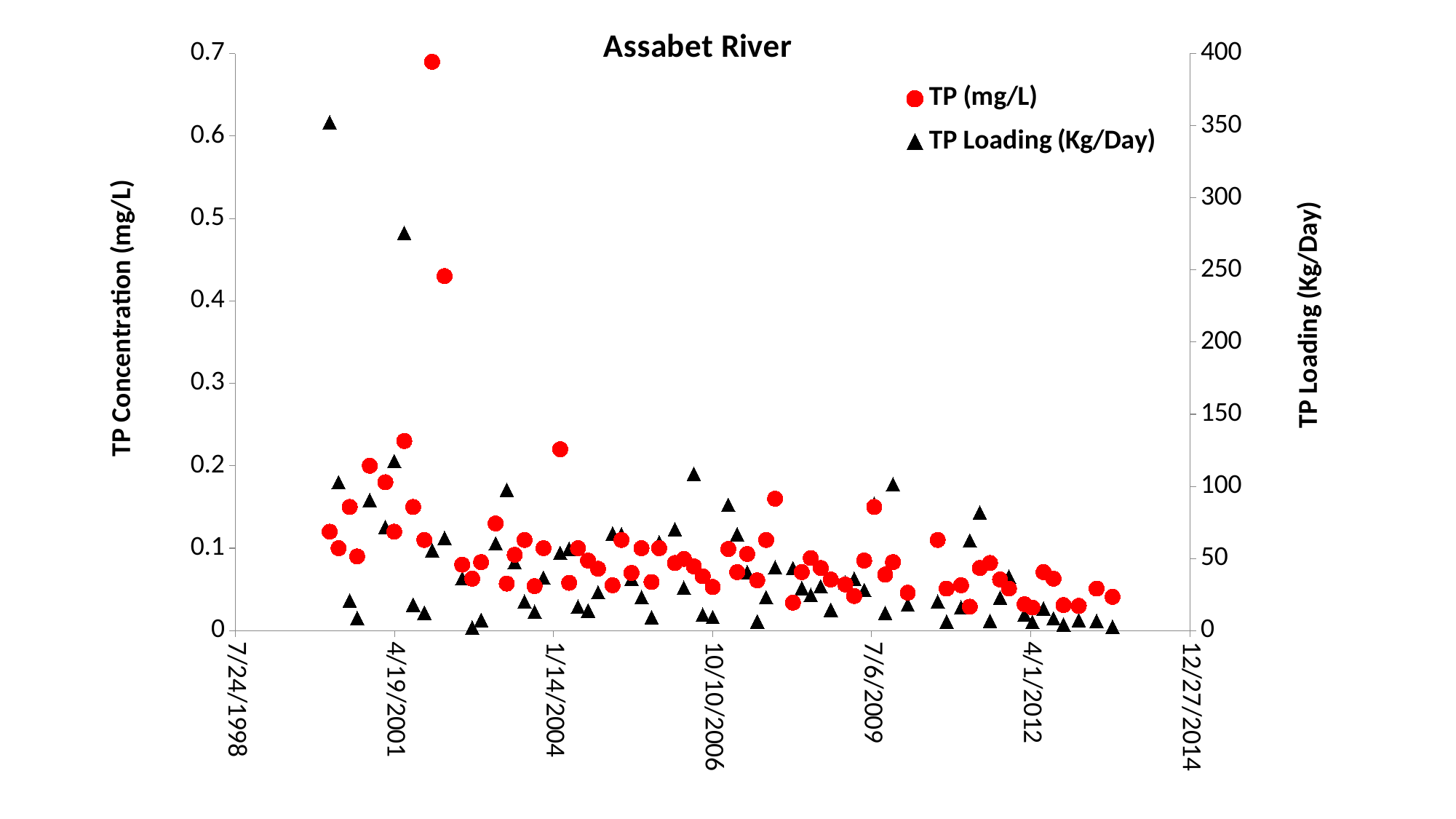
What is the title of the chart? Assabet River Which series is plotted with red circles? TP (mg/L) What is the last date label shown on the x axis? 12/27/2014 Is the highest TP (mg/L) value greater or less than 0.6? greater Do the TP (mg/L) values generally rise or fall from left to right along the x axis? Fall How many series does the legend list? 2 Do the TP Loading (Kg/Day) values generally rise or fall over time? Fall Is the highest TP Loading (Kg/Day) value greater or less than 300? greater Is the highest TP Loading (Kg/Day) value greater or less than 400? less What kind of chart is this? Scatter chart